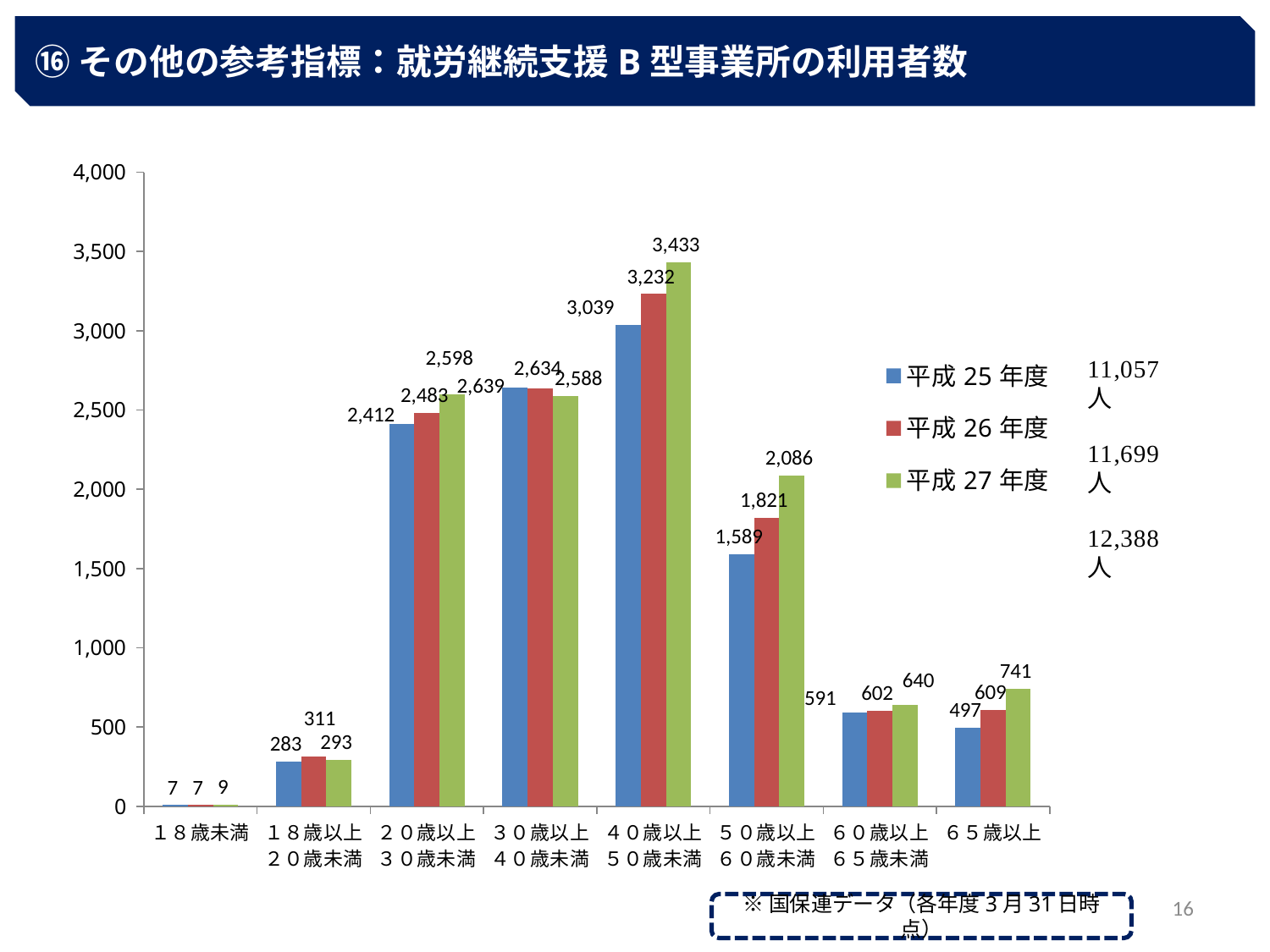
Which age category has the highest value for 平成27年度? 40歳以上50歳未満 For 平成27年度, which is larger: the value for 65歳以上 or the value for 60歳以上65歳未満? 65歳以上 What is the value for 平成25年度 in the 50歳以上60歳未満 category? 1,589 What kind of chart is shown on the slide? bar chart What is the difference between the 平成27年度 and 平成25年度 values in the 50歳以上60歳未満 category? 497 What is the difference between the 平成27年度 and 平成26年度 values in the 40歳以上50歳未満 category? 201 How many series does the legend list? 3 What is the value for 平成26年度 in the 18歳以上20歳未満 category? 311 Is the value for 平成26年度 in the 40歳以上50歳未満 category greater or less than 3,000? greater How many age categories are shown on the x axis? 8 Which age category has the lowest value for 平成25年度? 18歳未満 What is the value for 平成27年度 in the 40歳以上50歳未満 category? 3,433